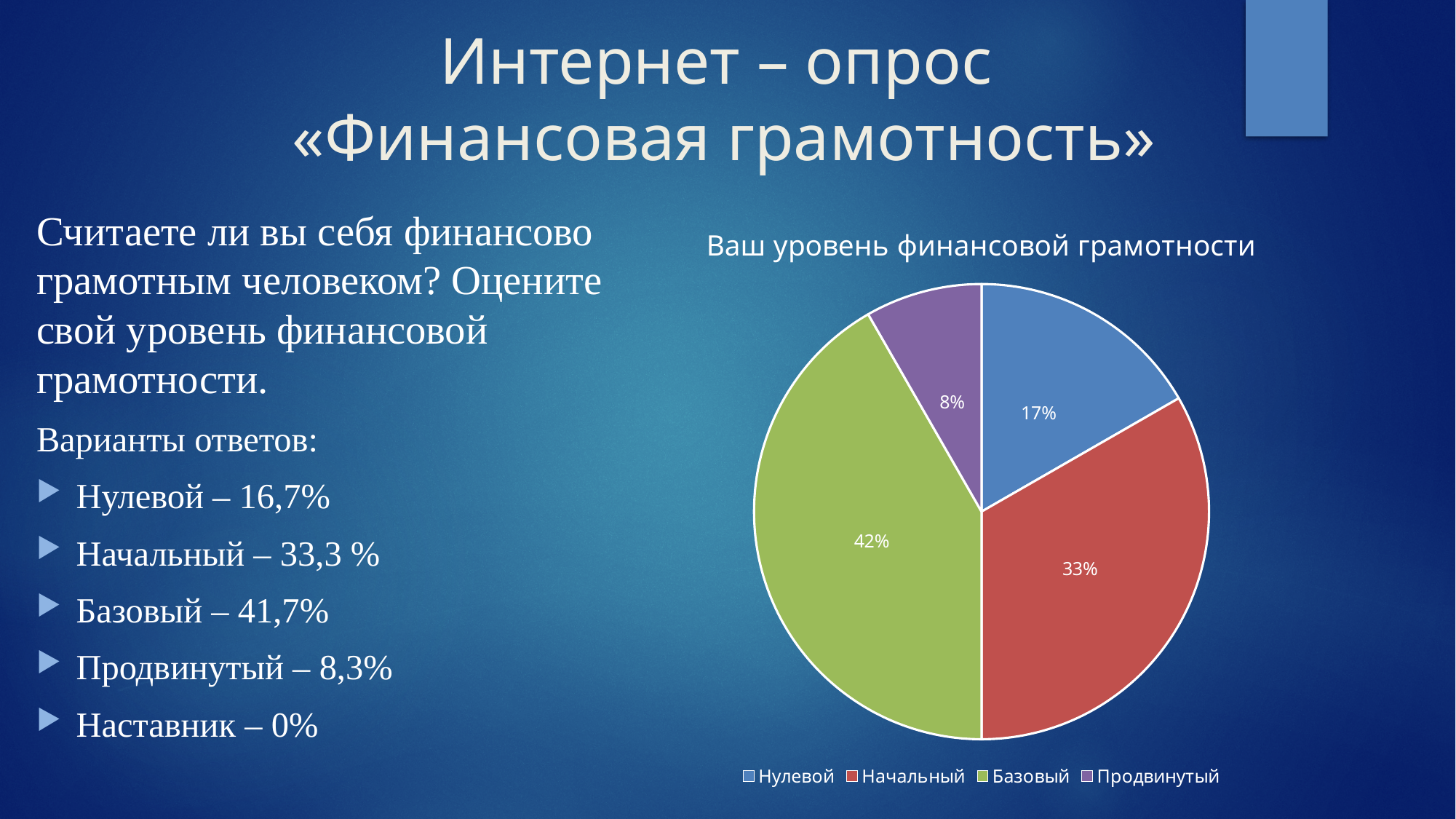
How many slices does the pie chart have? 4 What kind of chart is shown on the slide? pie chart Which is larger, the Начальный slice or the Нулевой slice? Начальный What percentage is shown for the Нулевой slice? 17% What percentage is shown for the Базовый slice? 42% Which category has the smallest slice of the pie? Продвинутый What is the title of the chart? Ваш уровень финансовой грамотности What is the difference in percentage points between the Базовый and Начальный slices? 9 What percentage is shown for the Продвинутый slice? 8% How many entries does the legend list? 4 Which category has the largest slice of the pie? Базовый What percentage is shown for the Начальный slice? 33%